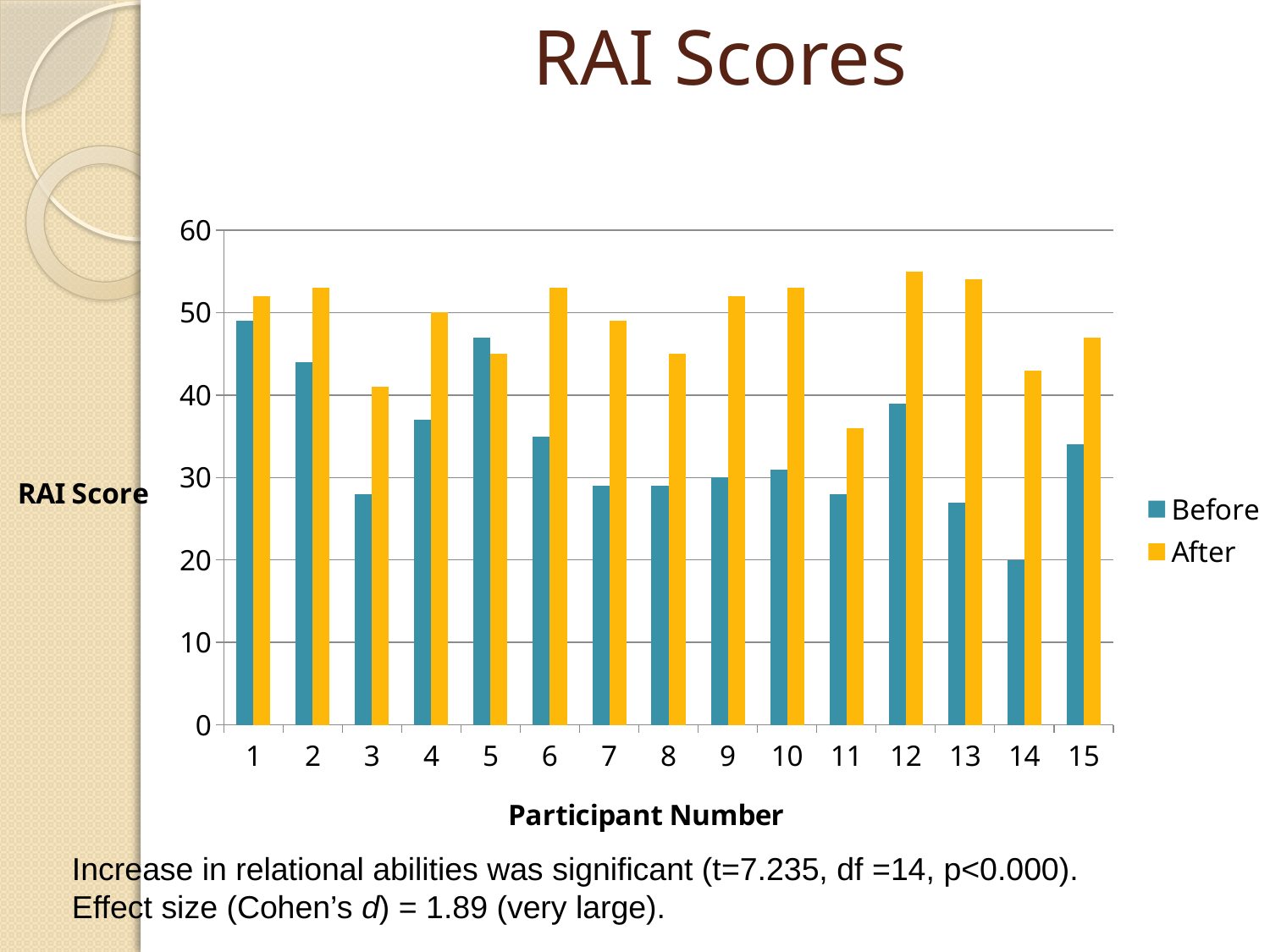
For participant 14, which is larger, the Before score or the After score? After Is the After score for participant 12 greater or less than 50? greater Is the Before score for participant 1 greater or less than 40? greater What is the Before score for participant 14? 20 How many series does the chart's legend list? 2 What is the title of the x axis? Participant Number What type of chart is shown on the slide? bar chart Is the After score for participant 11 greater or less than 40? less How many participants are shown on the x axis of the chart? 15 What are the two series named in the legend? Before and After Which participant has the lowest After score? 11 Which participant has the lowest Before score? 14